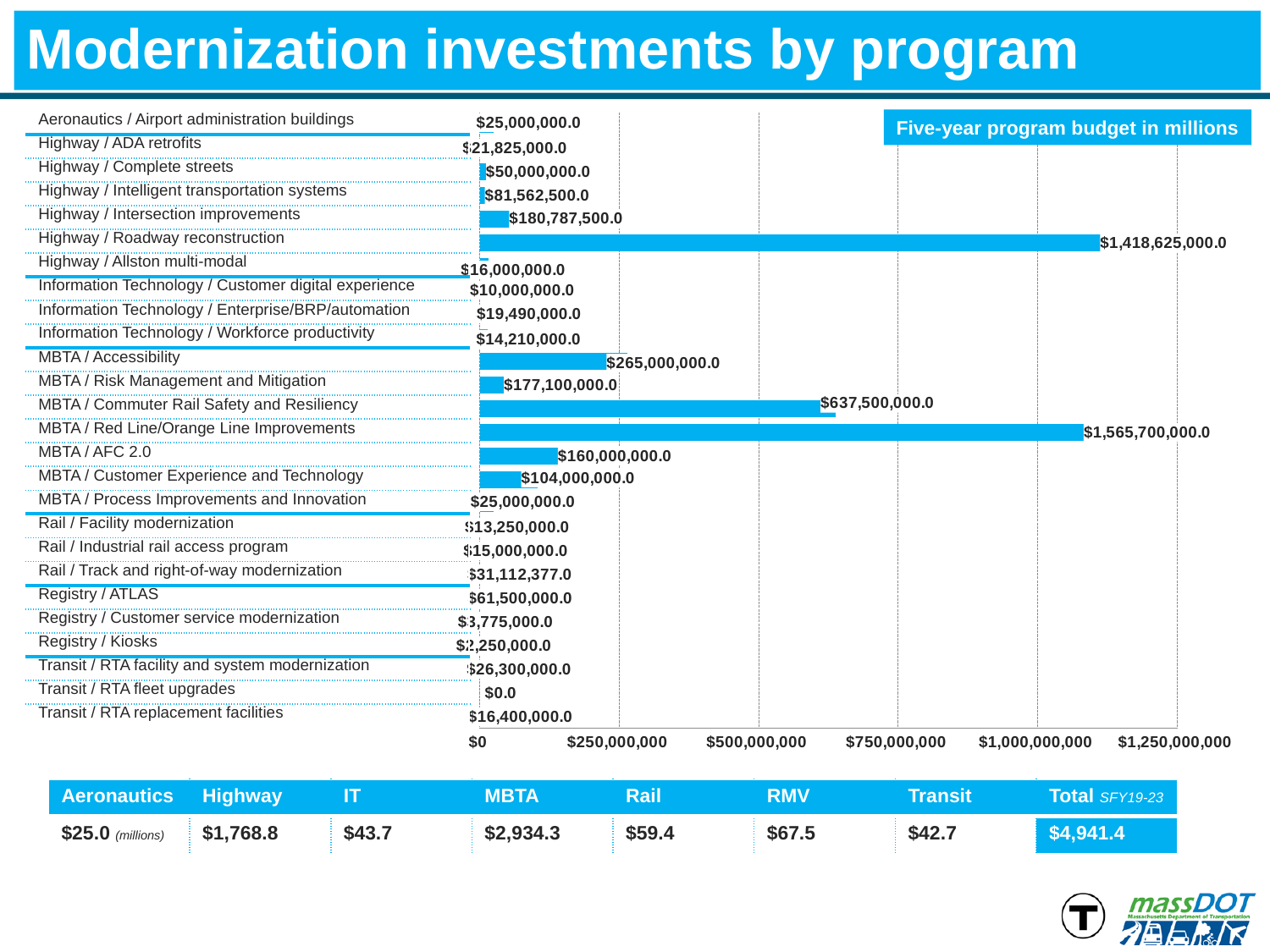
What is the difference between the values for MBTA / Red Line/Orange Line Improvements and Highway / Roadway reconstruction? $147,075,000.0 What kind of chart is shown on the slide? bar chart What is the value shown for Rail / Track and right-of-way modernization? $31,112,377.0 What is the value shown for Registry / ATLAS? $61,500,000.0 Which program has the lowest investment value in the chart? Transit / RTA fleet upgrades Which is larger, the value for MBTA / Accessibility or the value for Highway / Intersection improvements? MBTA / Accessibility What is the title of the slide containing the chart? Modernization investments by program What is the value shown for Highway / Roadway reconstruction? $1,418,625,000.0 How many programs (categories) are plotted in the chart? 26 Is the value for MBTA / Commuter Rail Safety and Resiliency greater or less than $500,000,000? greater Which program has the highest investment value in the chart? MBTA / Red Line/Orange Line Improvements What is the difference between the values for MBTA / AFC 2.0 and MBTA / Customer Experience and Technology? $56,000,000.0